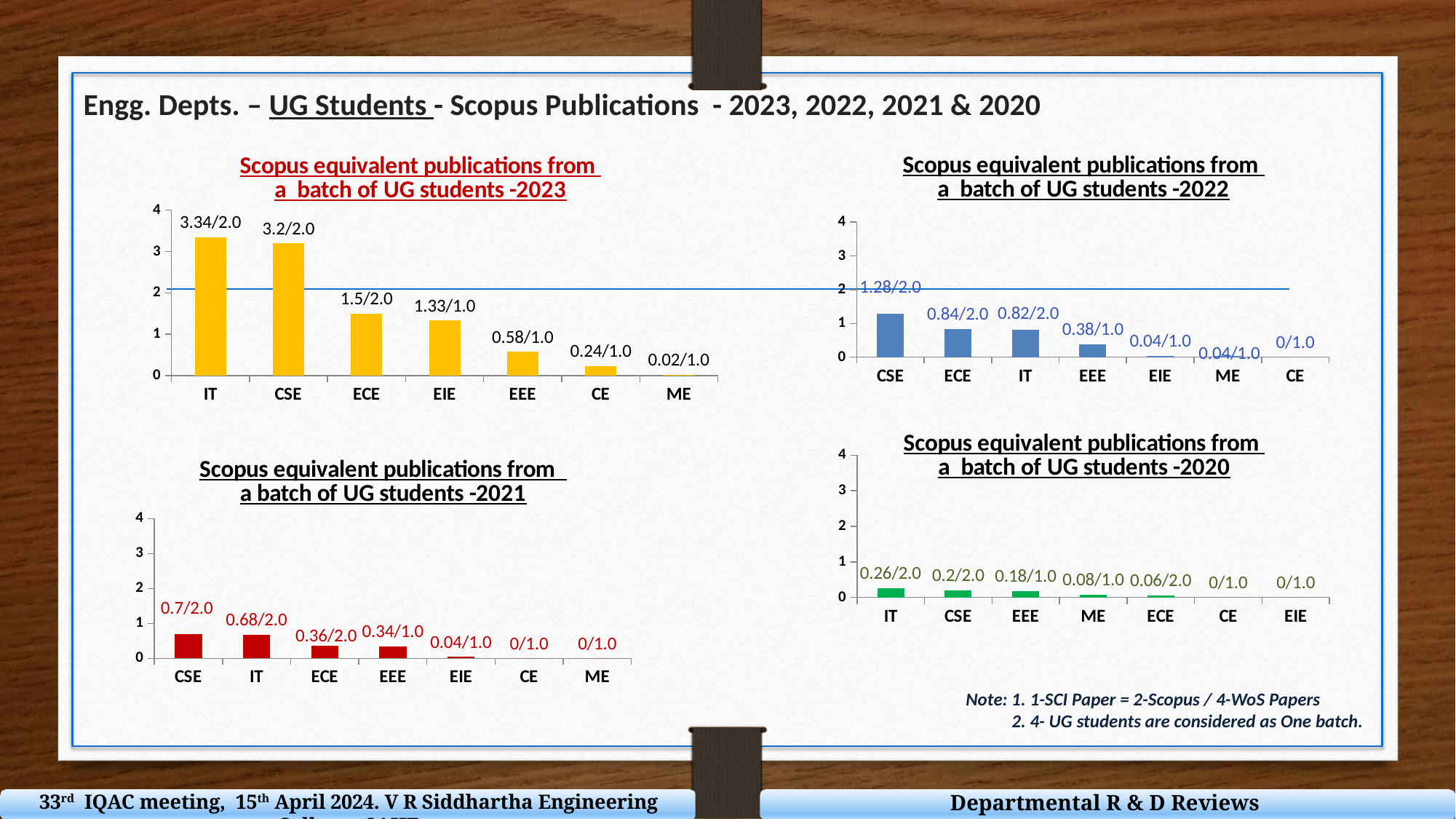
In the 2023 chart, what is the data label shown for IT? 3.34/2.0 In the 2022 chart, which department has the highest bar? CSE In the 2020 chart, which is larger, the value for IT or the value for ECE? IT In the 2023 chart, what is the difference between the plotted values for IT (3.34) and ECE (1.5)? 1.84 What kind of chart is the 2022 chart? Bar chart How many departments are shown on the x axis of the 2021 chart? 7 In the 2023 chart, is the value for IT greater or less than 3? greater In the 2020 chart, what is the data label shown for ME? 0.08/1.0 In the 2022 chart, what is the data label shown for EEE? 0.38/1.0 In the 2021 chart, what is the data label shown for ECE? 0.36/2.0 In the 2023 chart, which department has the highest bar? IT In the 2023 chart, which department has the lowest bar? ME